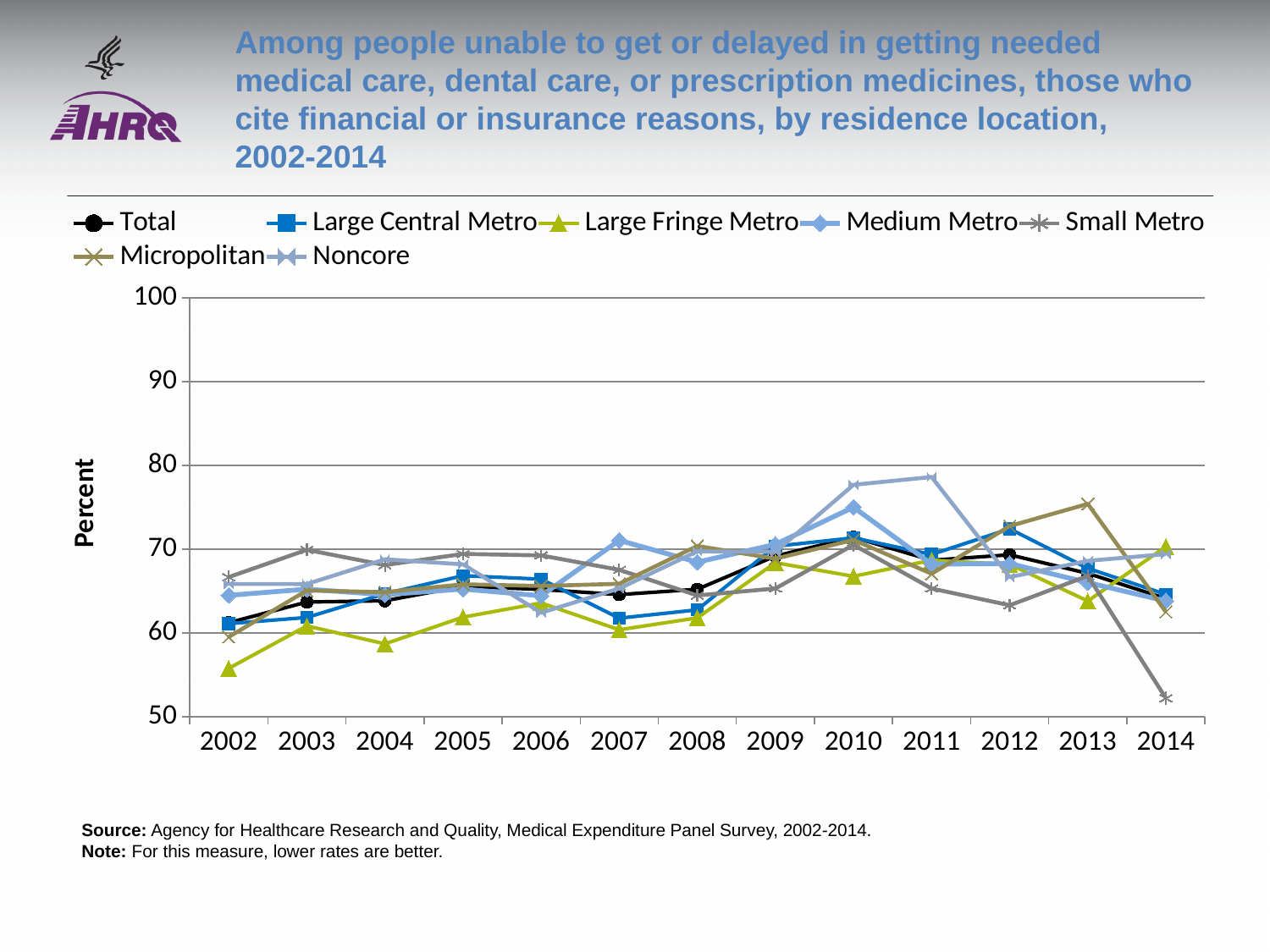
In 2014, which is larger: the value for Large Fringe Metro or the value for Small Metro? Large Fringe Metro Which residence location has the highest value in 2011? Noncore How many years are shown along the x axis? 13 Is the value for Noncore in 2011 greater or less than 70? greater What kind of chart is shown on the slide? line chart How many series does the legend list? 7 Does the value for Small Metro rise or fall from 2013 to 2014? fall Is the value for Small Metro in 2014 greater or less than 60? less Is the value for Large Fringe Metro in 2004 greater or less than 60? less Which residence location has the lowest value in 2002? Large Fringe Metro Which residence location has the highest value in 2013? Micropolitan Which residence location has the lowest value in 2014? Small Metro